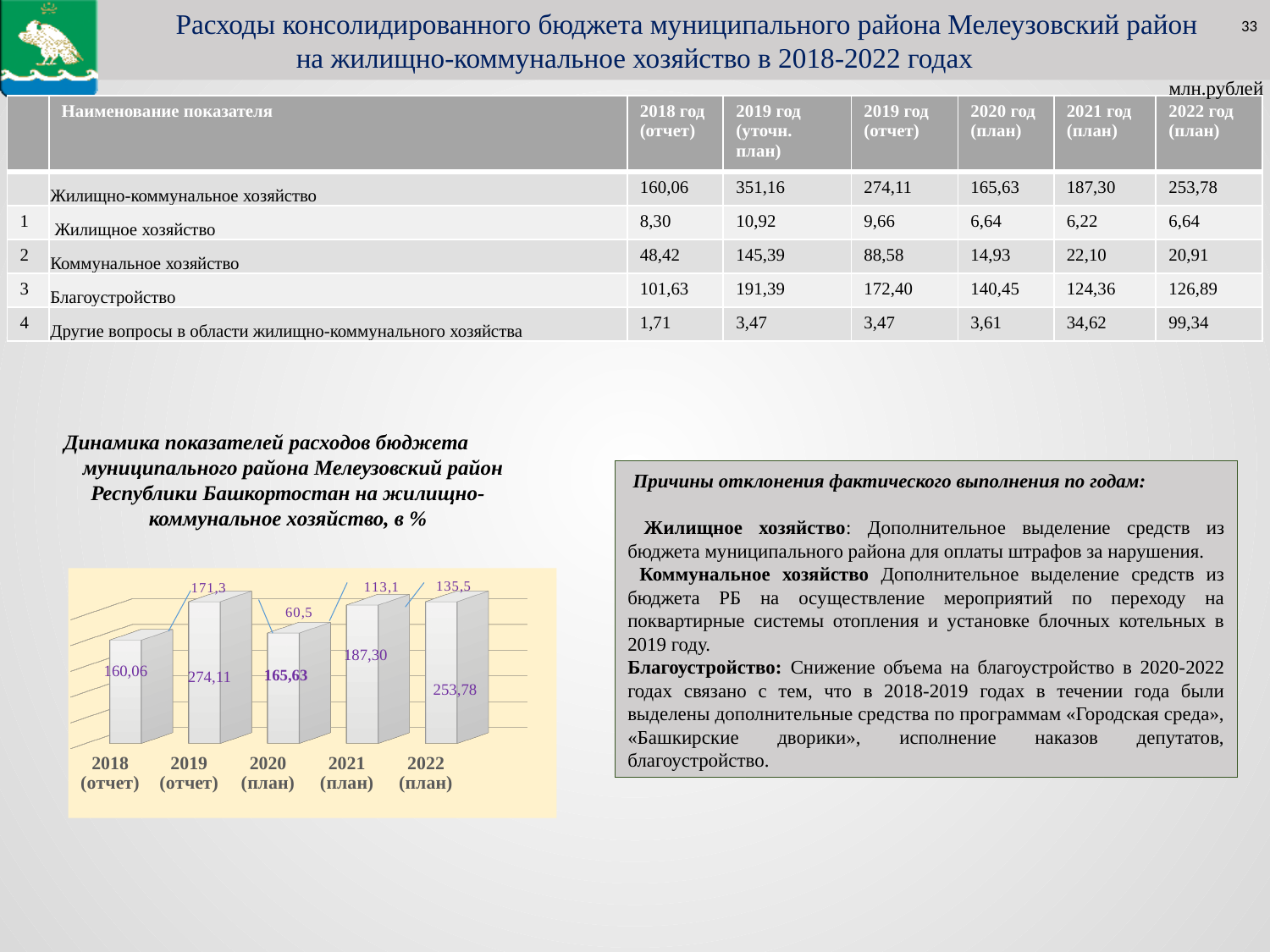
How many categories (years) are plotted on the chart? 5 What is the value for 2022 (план) on the chart? 253,78 What is the value for 2018 (отчет) on the chart? 160,06 What is the value for 2019 (отчет) on the chart? 274,11 Which is larger, the value for 2021 (план) or 2022 (план)? 2022 (план) What kind of chart is shown on the slide? bar chart What percentage label is shown above the 2019 (отчет) bar? 171,3 Which year has the highest value on the chart? 2019 (отчет) Which year has the lowest value on the chart? 2018 (отчет) Do the values rise or fall from 2020 (план) to 2022 (план)? rise What is the value for 2020 (план) on the chart? 165,63 What is the difference between the values for 2019 (отчет) and 2018 (отчет)? 114,05